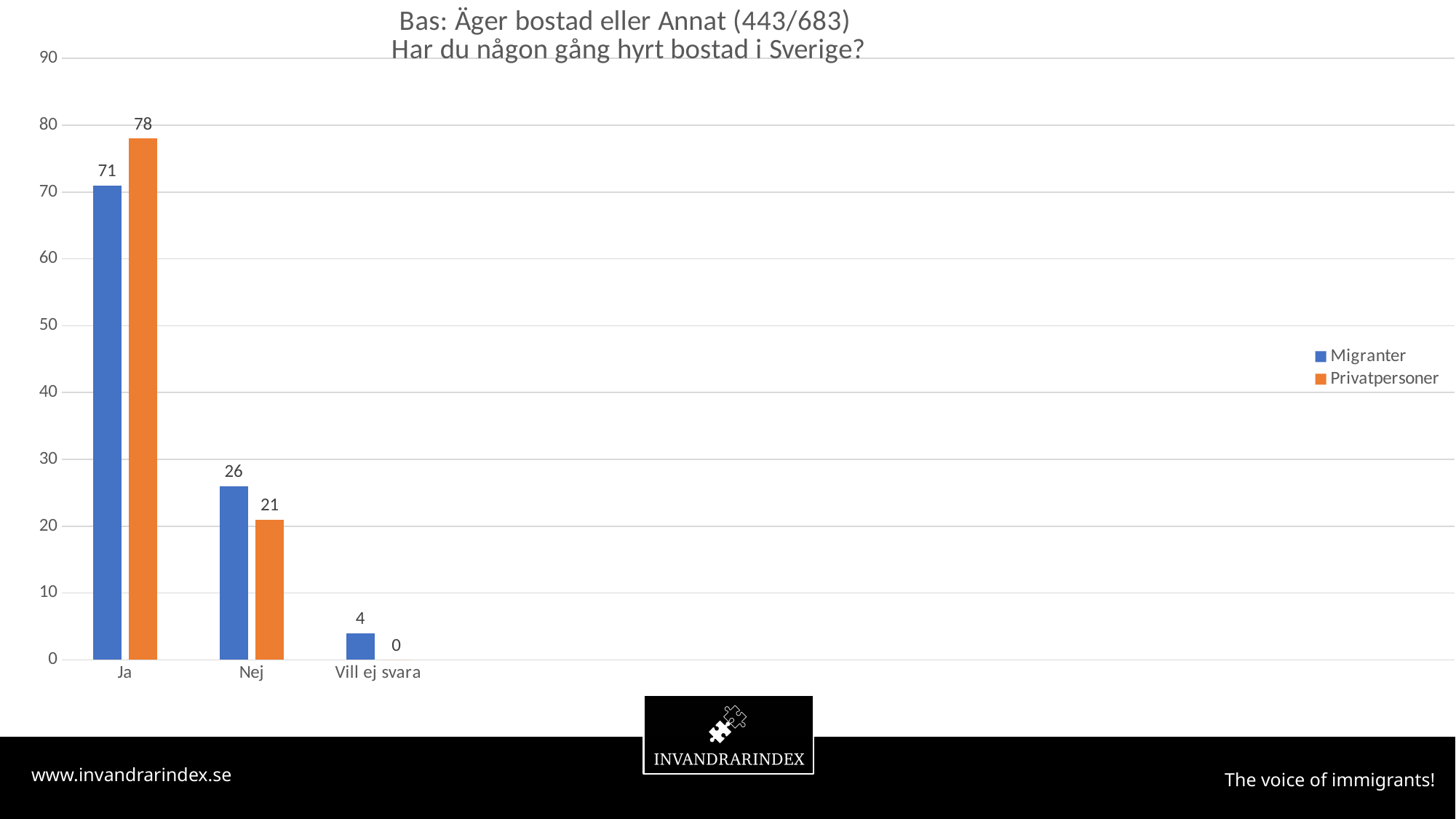
What is the difference between the Privatpersoner and Migranter values in the Ja category? 7 Is the value for Migranter in the Nej category greater or less than 30? less In the Nej category, which series has the larger value, Migranter or Privatpersoner? Migranter Which category has the highest value for Privatpersoner? Ja What kind of chart is shown on the slide? Bar chart Which colour represents the Privatpersoner series? Orange What is the value for Migranter in the Ja category? 71 Which category has the lowest value for Migranter? Vill ej svara What is the value for Privatpersoner in the Vill ej svara category? 0 How many series does the legend list? 2 What is the value for Privatpersoner in the Nej category? 21 How many categories are shown on the x axis? 3